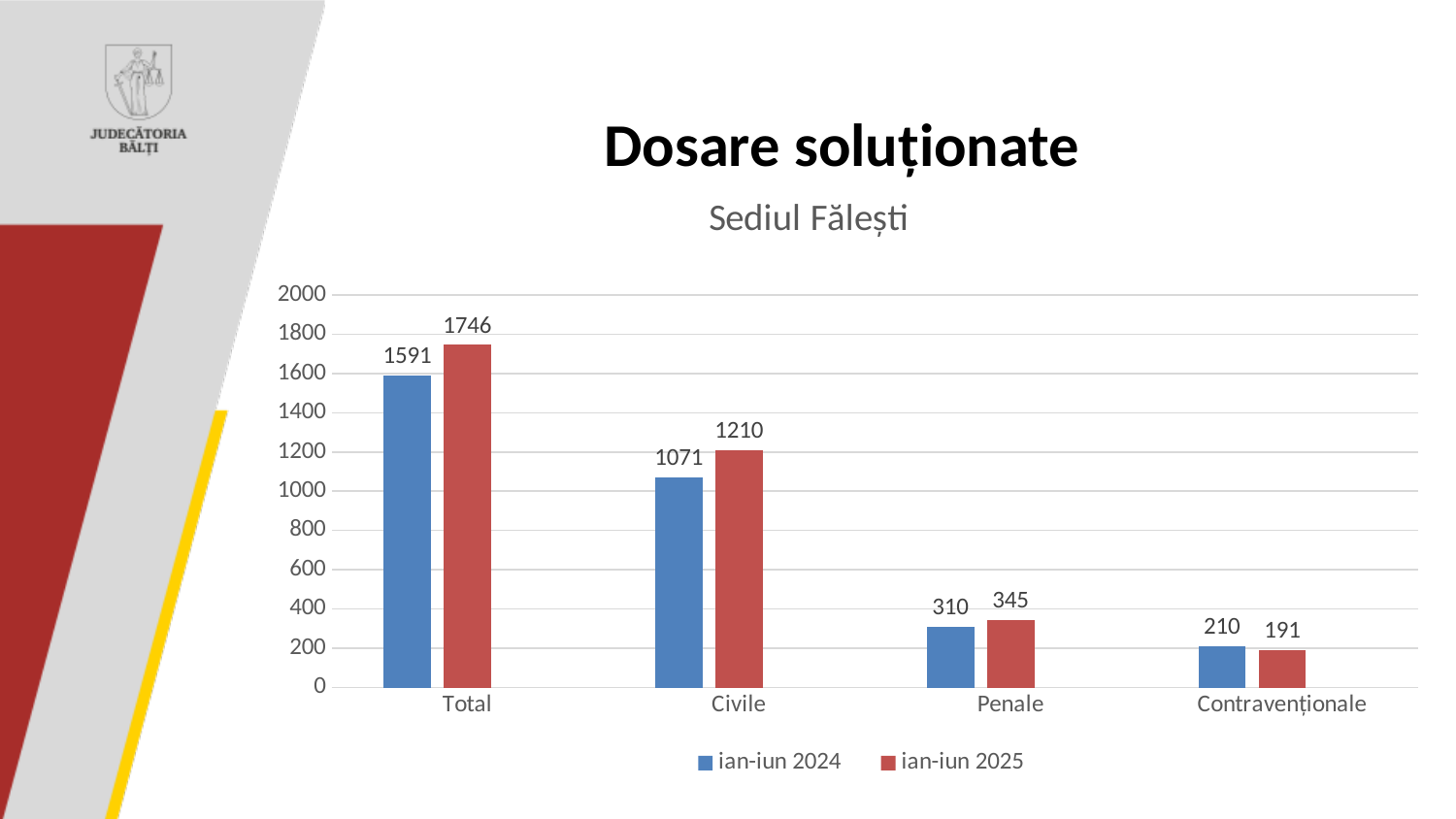
What is the value for Contravenționale in the ian-iun 2025 series? 191 How many categories are shown on the x axis? 4 What is the subtitle shown below the chart title? Sediul Fălești What is the value for Penale in the ian-iun 2024 series? 310 What kind of chart is shown on the slide? bar chart What is the difference between the ian-iun 2024 and ian-iun 2025 values for Contravenționale? 19 How many series does the legend list? 2 What is the value for Civile in the ian-iun 2025 series? 1210 Which category has the highest value in the ian-iun 2025 series? Total What is the difference between the ian-iun 2025 and ian-iun 2024 values for Total? 155 Which category has the lowest value in the ian-iun 2024 series? Contravenționale Which is larger for Penale: the ian-iun 2024 value or the ian-iun 2025 value? ian-iun 2025